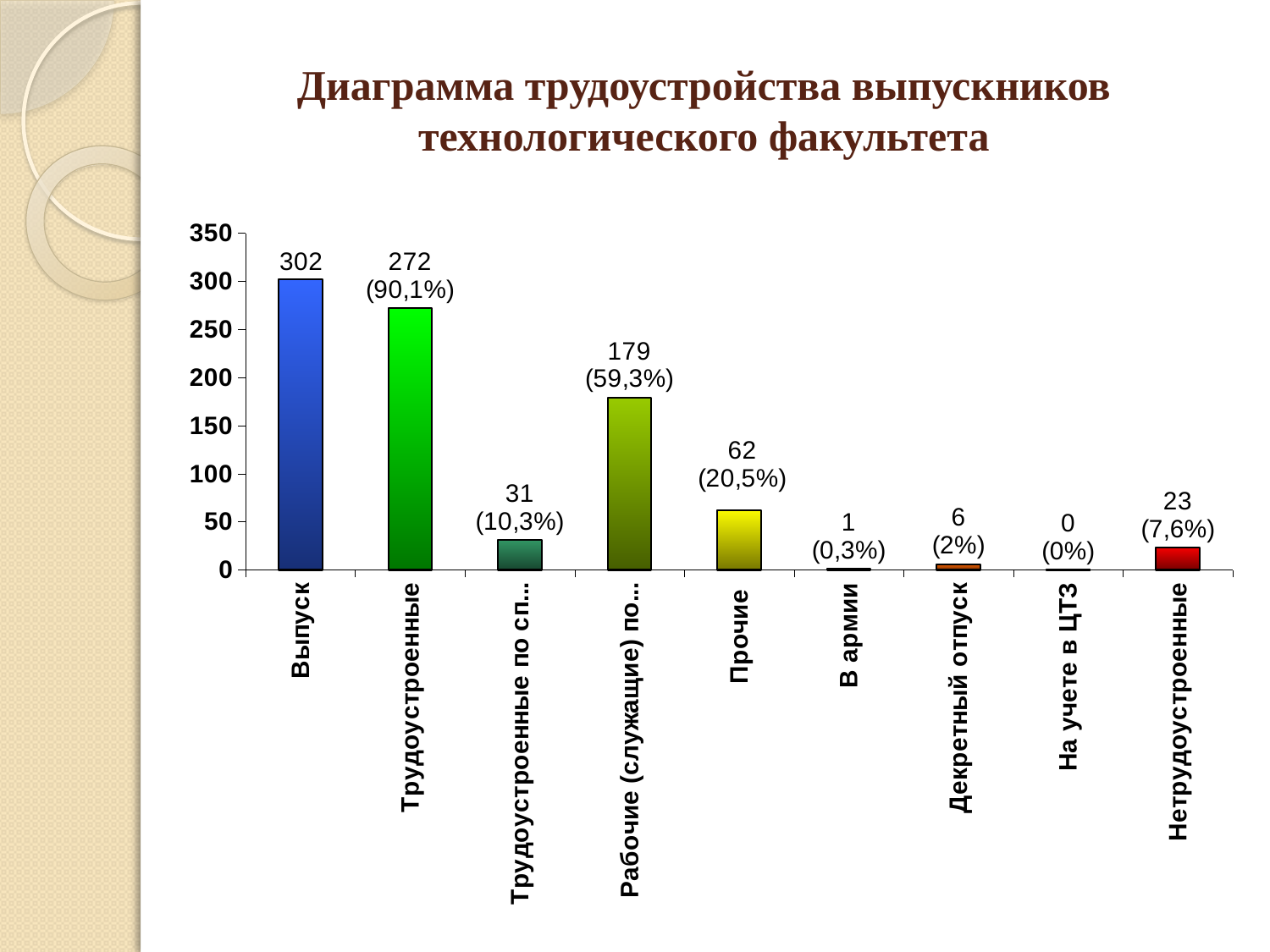
What kind of chart is this? Bar chart Which is larger, the value for Прочие or the value for Нетрудоустроенные? Прочие Which category has the highest value? Выпуск Which category has the lowest value? На учете в ЦТЗ What is the title of the chart? Диаграмма трудоустройства выпускников технологического факультета What is the value for Трудоустроенные? 272 How many categories are shown on the x axis? 9 What is the value for Нетрудоустроенные? 23 What is the value for Декретный отпуск? 6 What percentage is shown for Прочие? 20,5% What is the value for Выпуск? 302 What is the difference between the values for Выпуск and Трудоустроенные? 30